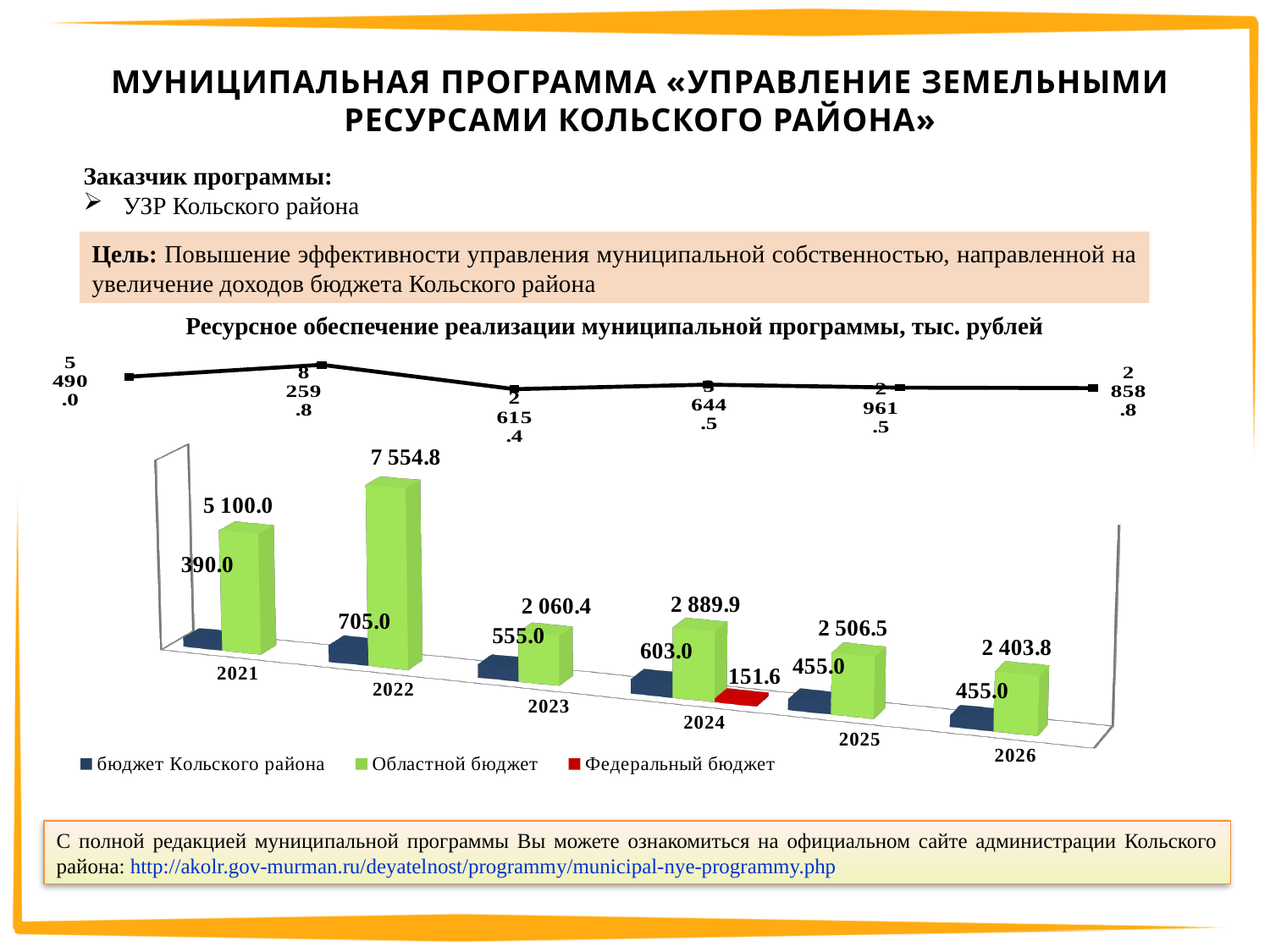
How many years are shown on the x axis of the chart? 6 What is the title of the chart? Ресурсное обеспечение реализации муниципальной программы, тыс. рублей What is the value for бюджет Кольского района in 2024? 603.0 What kind of chart is used to show the budget values by year? bar chart How many series does the chart legend list? 3 In which year is the Областной бюджет value the lowest? 2023 What is the difference between the Областной бюджет values for 2022 and 2021? 2 454.8 Which is larger: бюджет Кольского района in 2022 or in 2023? 2022 What is the value for Федеральный бюджет in 2024? 151.6 What is the value for Областной бюджет in 2022? 7 554.8 Does the Областной бюджет value rise or fall from 2024 to 2026? fall In which year is the Областной бюджет value the highest? 2022